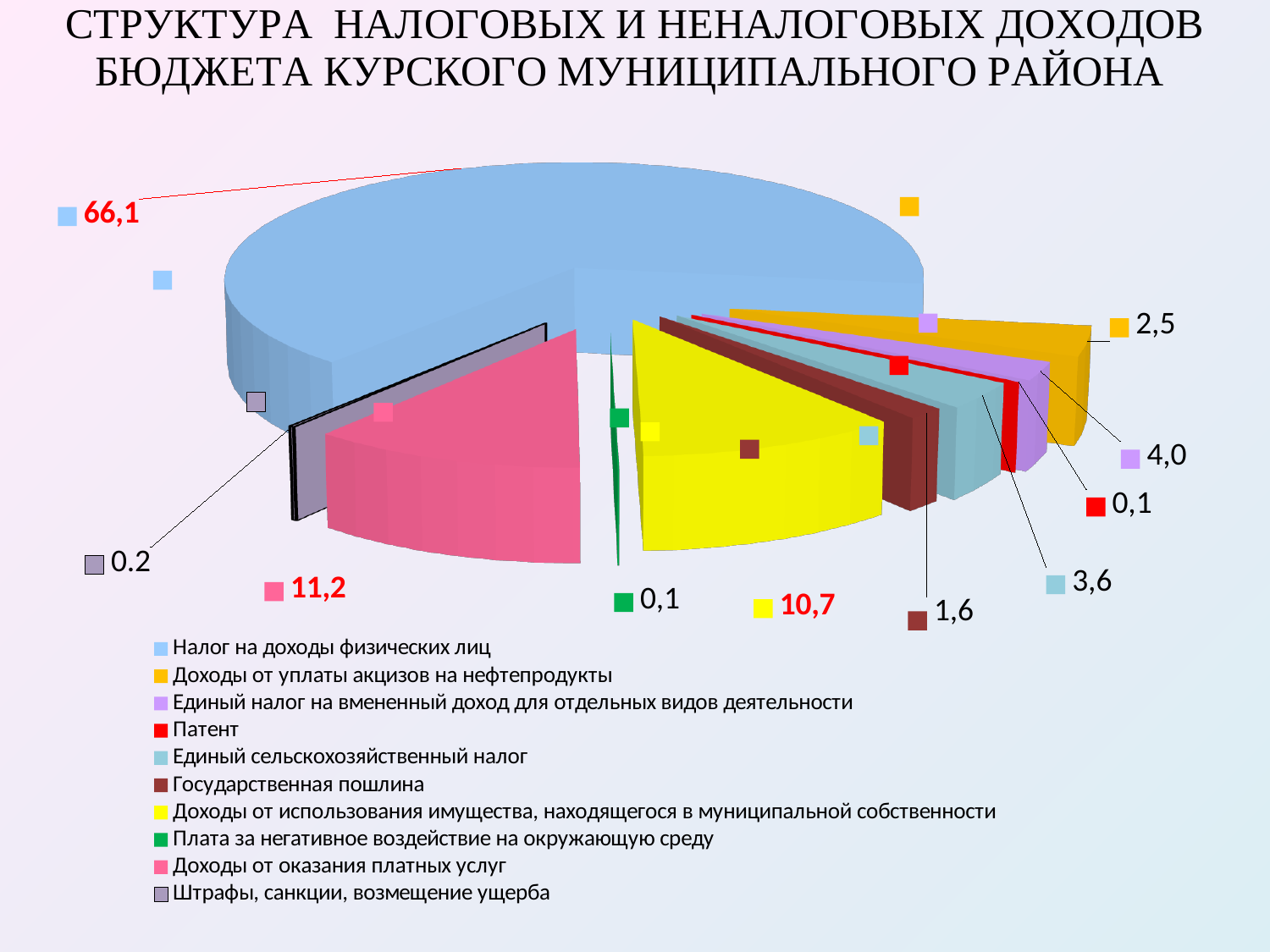
What is the value for Государственная пошлина? 1,6 What is the value for Налог на доходы физических лиц? 66,1 What is the value for Доходы от оказания платных услуг? 11,2 What is the value for Доходы от использования имущества, находящегося в муниципальной собственности? 10,7 What is the value for Доходы от уплаты акцизов на нефтепродукты? 2,5 Which category has the largest share of the pie? Налог на доходы физических лиц What is the value for Единый сельскохозяйственный налог? 3,6 How many categories does the legend list? 10 What is the difference between the values for Доходы от оказания платных услуг and Доходы от использования имущества, находящегося в муниципальной собственности? 0,5 What colour is the slice for Патент? red What kind of chart is shown on the slide? pie chart Which is larger, Единый налог на вмененный доход для отдельных видов деятельности or Единый сельскохозяйственный налог? Единый налог на вмененный доход для отдельных видов деятельности